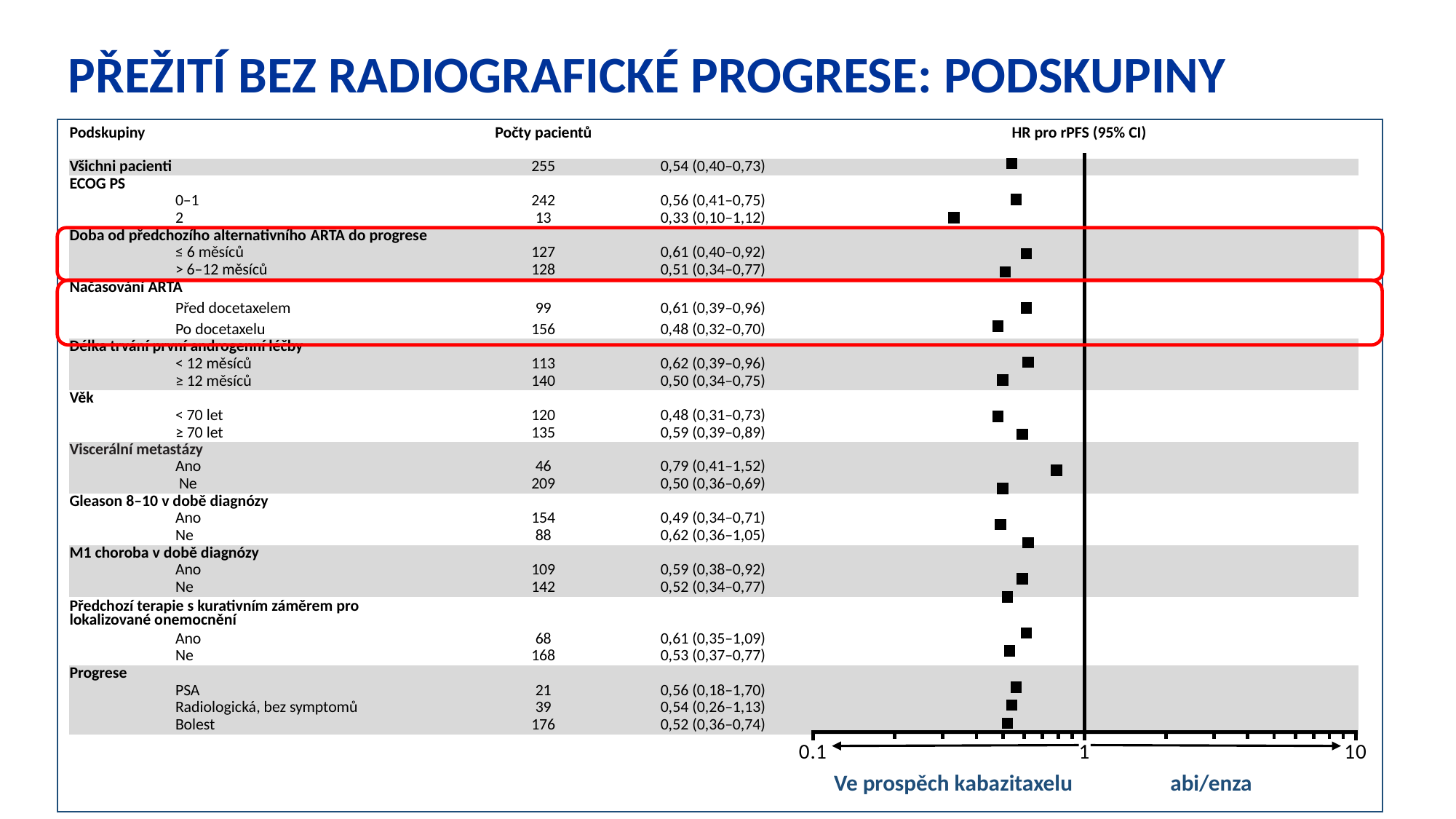
Which treatment is favoured by values to the left of 1 on the axis, according to the label below the plot? Kabazitaxel (Ve prospěch kabazitaxelu) Which has the larger HR point estimate: Před docetaxelem or Po docetaxelu? Před docetaxelem Which subgroup has the lowest hazard ratio point estimate? ECOG PS 2 (0,33) What kind of chart is shown on the right side of the slide? Forest plot What are the labelled tick values on the horizontal axis of the forest plot? 0.1, 1, 10 What is the total number of patients in the Viscerální metastázy Ano and Ne subgroups combined? 255 Which subgroup has the highest hazard ratio point estimate? Viscerální metastázy – Ano (0,79) What is the difference in patient numbers between the ≤ 6 měsíců and > 6–12 měsíců subgroups? 1 What is the hazard ratio for rPFS for all patients (Všichni pacienti)? 0,54 (0,40–0,73) Is the HR point estimate for all patients (Všichni pacienti) greater or less than 1? less What is the HR for rPFS in the subgroup ECOG PS 2? 0,33 (0,10–1,12) How many patients are in the subgroup with visceral metastases (Viscerální metastázy – Ano)? 46